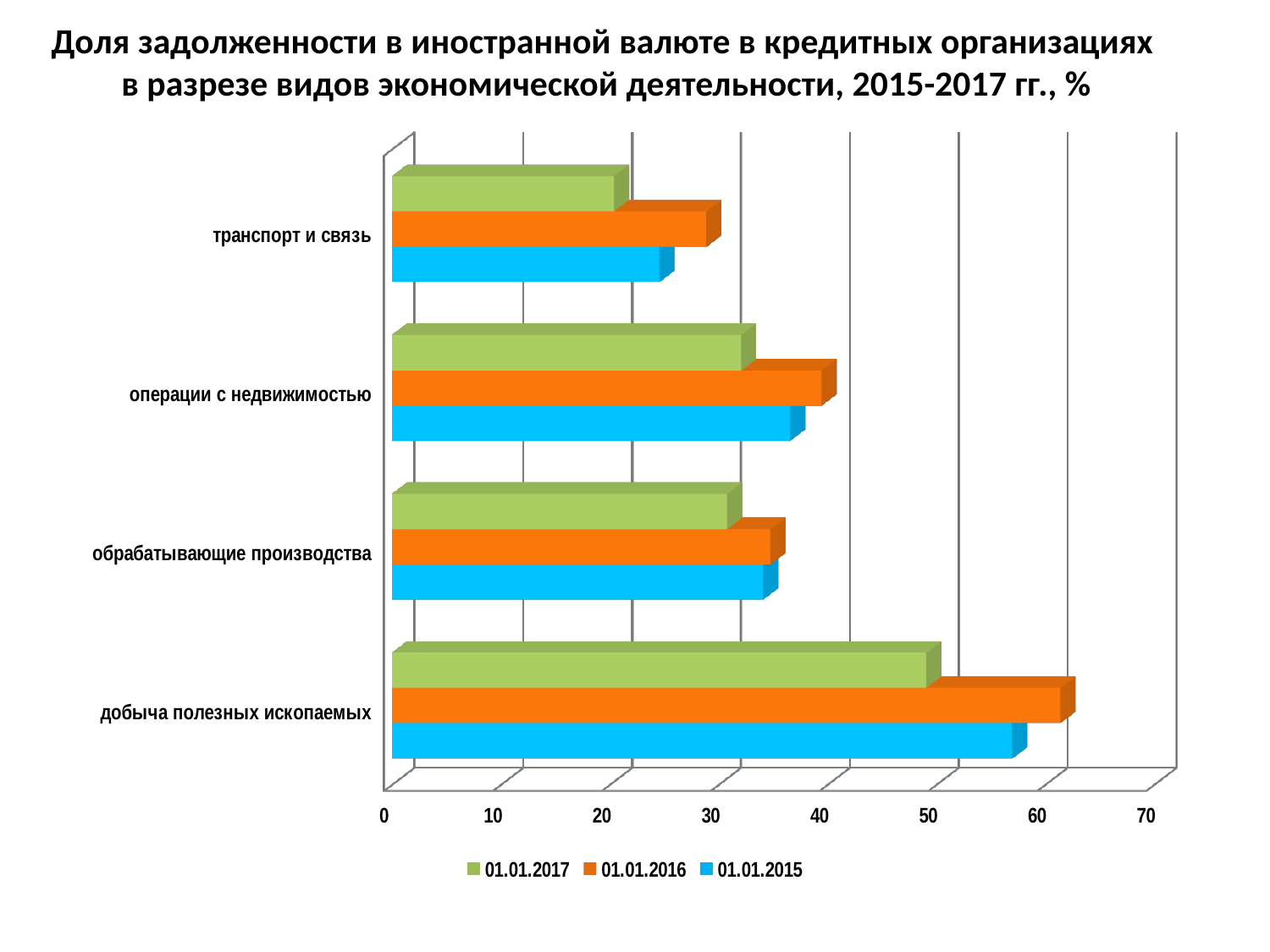
Which category has the highest value for 01.01.2016? добыча полезных ископаемых Which category has the lowest value for 01.01.2017? транспорт и связь How many categories (types of economic activity) are shown on the chart? 4 For добыча полезных ископаемых, which is larger: the value for 01.01.2015 or for 01.01.2017? 01.01.2015 Is the value for операции с недвижимостью on 01.01.2015 greater or less than 30? greater Is the value for добыча полезных ископаемых on 01.01.2016 greater or less than 50? greater What is the maximum value shown on the horizontal axis? 70 For транспорт и связь, which is larger: the value for 01.01.2016 or for 01.01.2017? 01.01.2016 Is the value for транспорт и связь on 01.01.2017 greater or less than 30? less Which series is shown in green on the chart? 01.01.2017 What kind of chart is shown on the slide? bar chart How many series does the legend list? 3